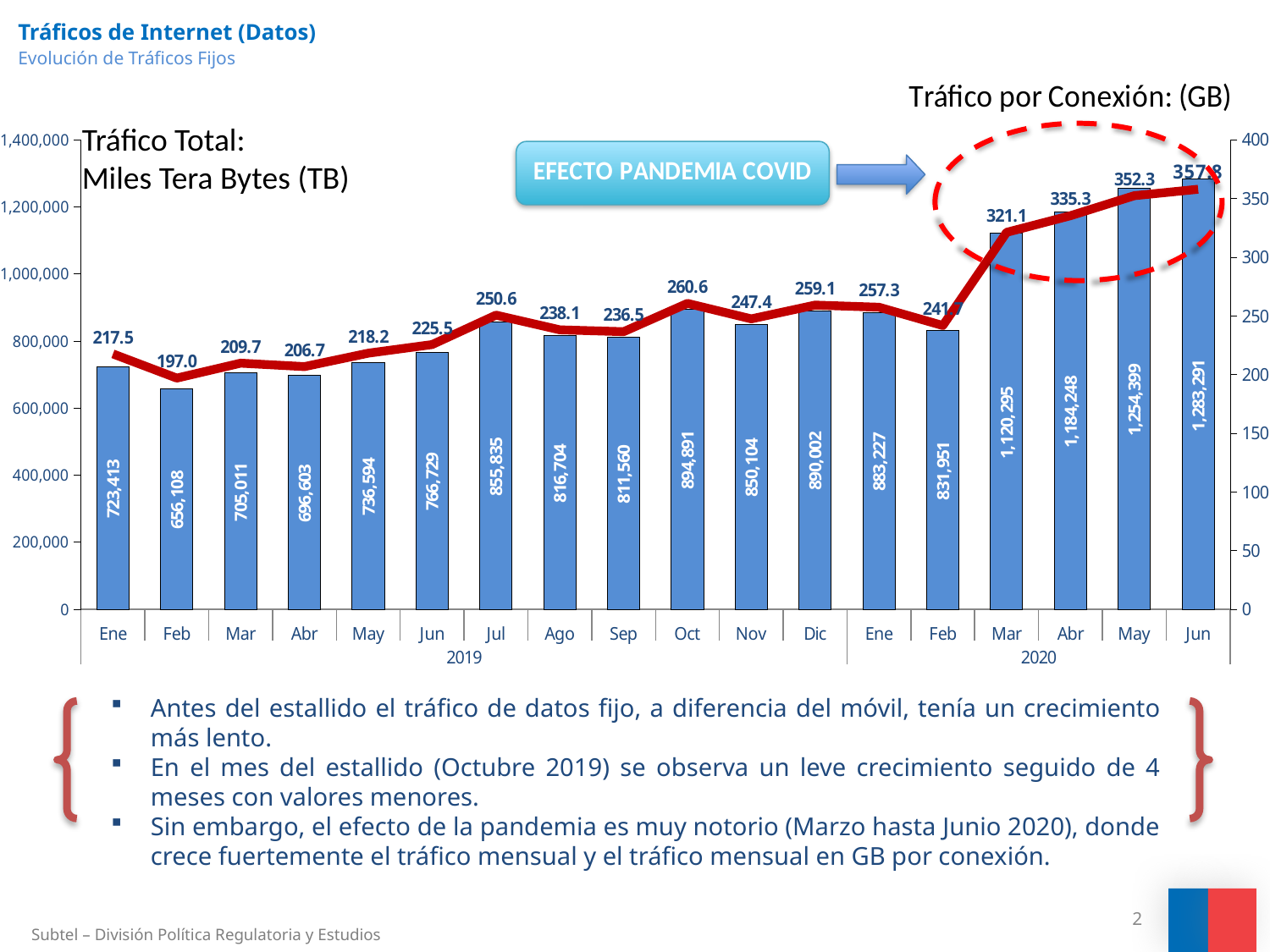
How many months are shown on the x axis of the chart? 18 Which is larger, the total fixed traffic for Oct 2019 or for Dic 2019? Oct 2019 Is the total fixed traffic for Jul 2019 greater or less than 800,000? greater What is the total fixed traffic (Tráfico Total) for Jun 2020? 1,283,291 What is the traffic per connection (Tráfico por Conexión) in GB for Oct 2019? 260.6 Does the traffic per connection (GB) rise or fall from Mar 2020 to May 2020? rise Which month has the highest total fixed traffic? Jun 2020 What kind of chart is used to show the total fixed traffic (Tráfico Total)? bar chart Which month has the lowest traffic per connection (GB)? Feb 2019 What is the total fixed traffic for Feb 2019? 656,108 What text is shown in the callout box with the arrow pointing to the circled area? EFECTO PANDEMIA COVID What is the difference in total fixed traffic between Mar 2020 and Feb 2020? 288,344